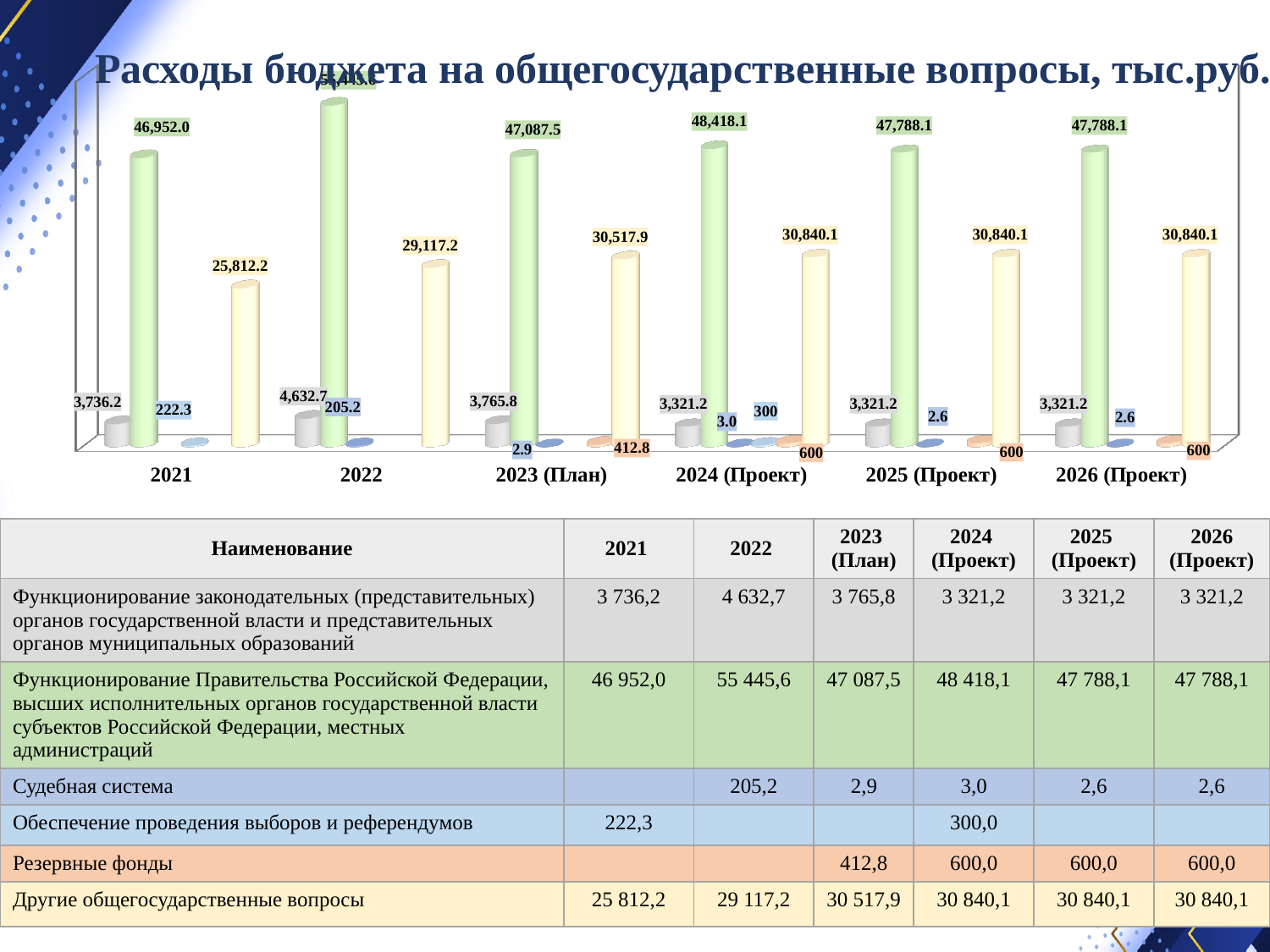
Do the yellow bar values rise or fall from 2021 to 2024 (Проект)? rise What is the difference between the green bar values for 2024 (Проект) and 2023 (План)? 1,330.6 What is the difference between the yellow bar values for 2022 and 2021? 3,305.0 In which year is the green bar the tallest? 2022 In which year is the yellow bar the lowest? 2021 What is the value labelled for the reserve funds (orange) bar in 2024 (Проект)? 600 What is the value of the grey bar for 2022? 4,632.7 Which year has the larger grey bar, 2021 or 2022? 2022 What is the value of the yellow bar for 2023 (План)? 30,517.9 How many year categories are shown along the x axis of the chart? 6 What is the value of the tallest (green) bar for 2021? 46,952.0 What type of chart is shown on the slide? bar chart